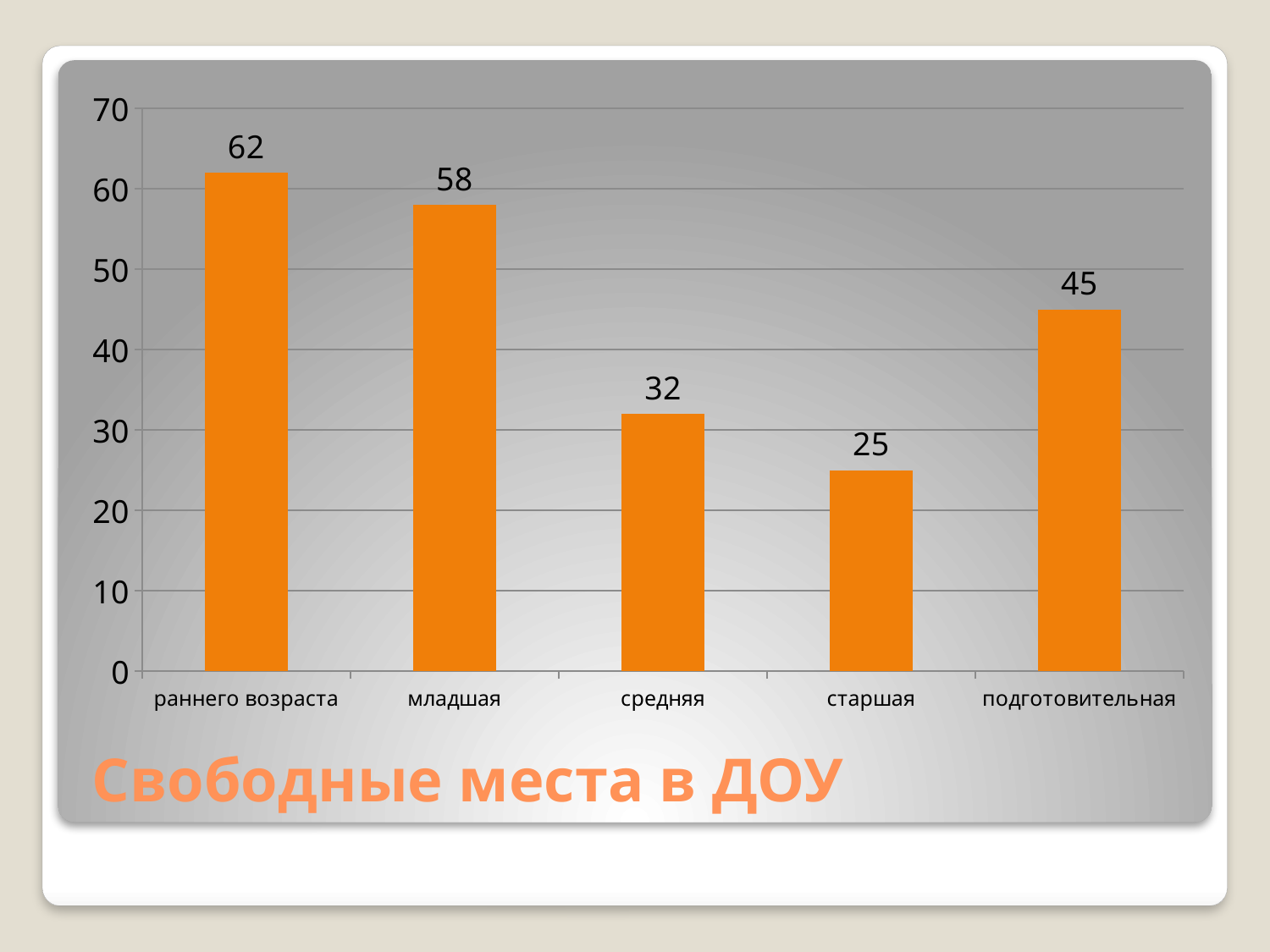
What is the difference between the values for раннего возраста and старшая? 37 What is the value for старшая? 25 What is the title of the chart? Свободные места в ДОУ What is the value for средняя? 32 What is the value for раннего возраста? 62 Which category has the lowest value? старшая What kind of chart is shown on the slide? bar chart What is the value for подготовительная? 45 Which is larger, the value for подготовительная or the value for средняя? подготовительная What is the value for младшая? 58 Which category has the highest value? раннего возраста How many categories are shown on the x axis? 5